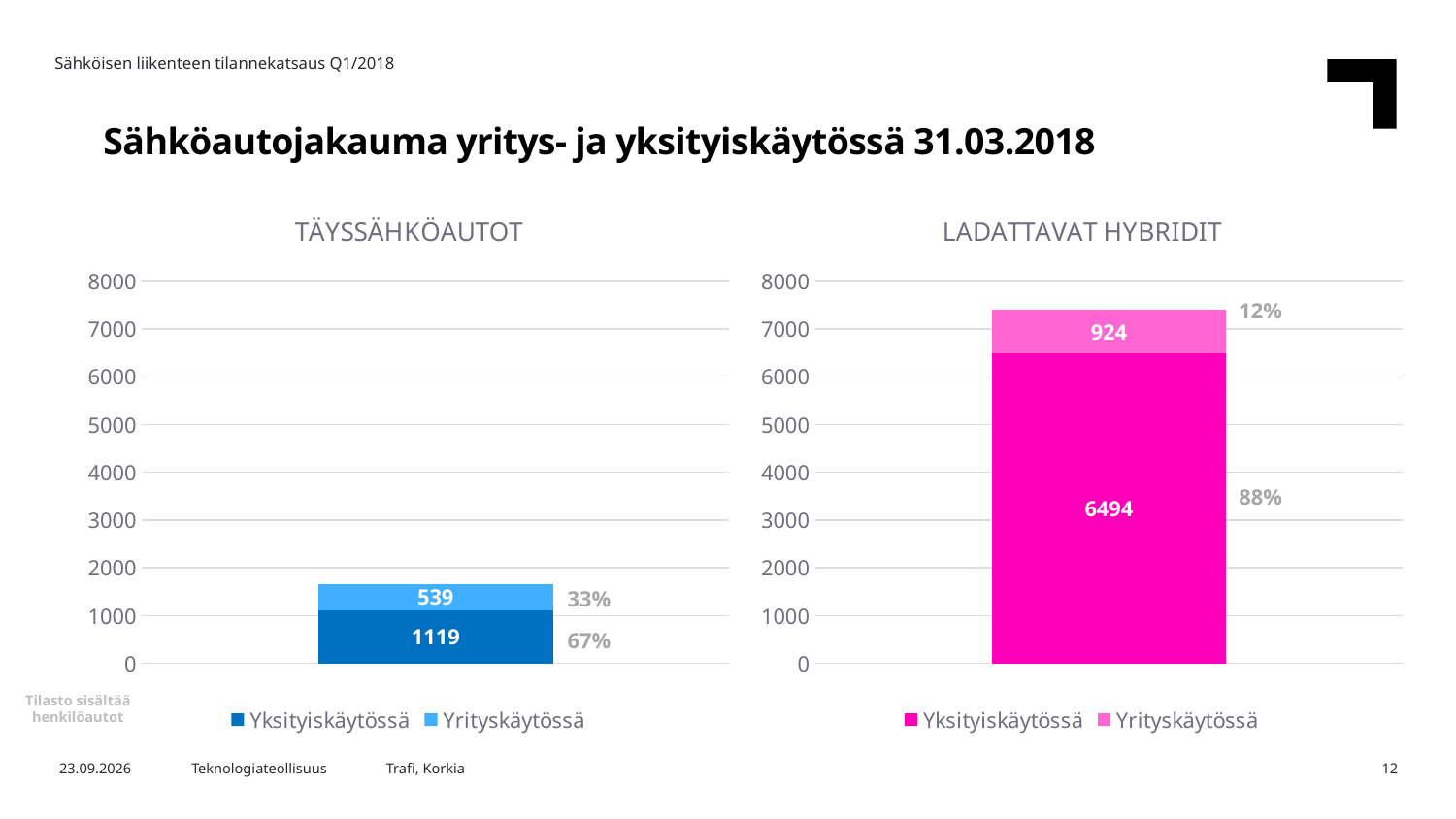
In the LADATTAVAT HYBRIDIT chart, what is the total of the stacked bar? 7418 In the LADATTAVAT HYBRIDIT chart, what is the difference between Yksityiskäytössä and Yrityskäytössä? 5570 In the TÄYSSÄHKÖAUTOT chart, what is the value for Yksityiskäytössä? 1119 In the TÄYSSÄHKÖAUTOT chart, what is the value for Yrityskäytössä? 539 In the TÄYSSÄHKÖAUTOT chart, what percentage share is shown for Yksityiskäytössä? 67% In the TÄYSSÄHKÖAUTOT chart, which is larger, Yksityiskäytössä or Yrityskäytössä? Yksityiskäytössä In the TÄYSSÄHKÖAUTOT chart, what is the total of the stacked bar? 1658 In the LADATTAVAT HYBRIDIT chart, what is the value for Yrityskäytössä? 924 In the LADATTAVAT HYBRIDIT chart, what is the value for Yksityiskäytössä? 6494 What kind of chart is the TÄYSSÄHKÖAUTOT chart? Stacked bar chart In the LADATTAVAT HYBRIDIT chart, what percentage share is shown for Yrityskäytössä? 12% How many series does the legend of the LADATTAVAT HYBRIDIT chart list? 2